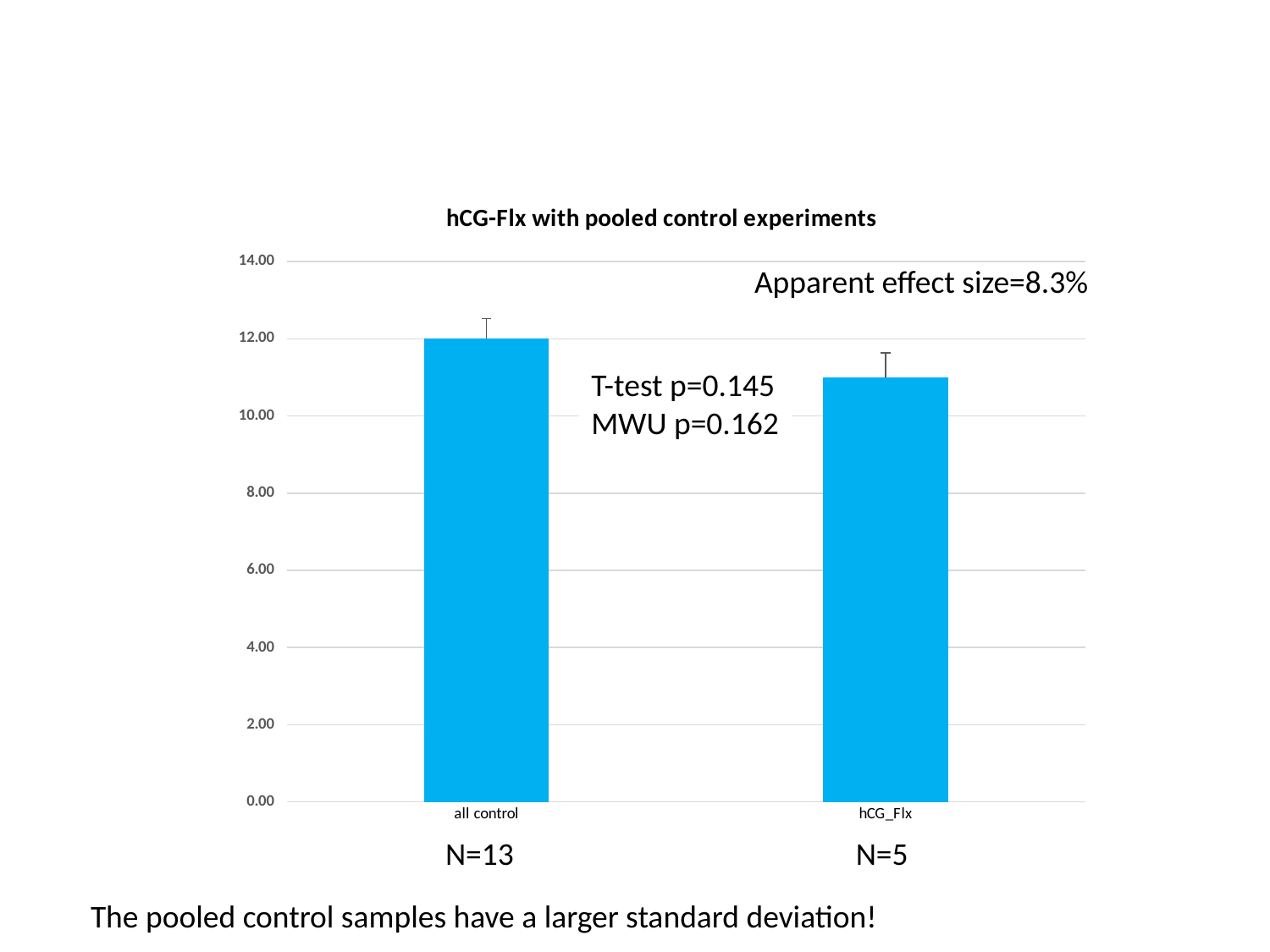
Is the value for hCG_Flx greater or less than 10.00? greater Is the value for all control greater or less than 10.00? greater What is the value of the bar for all control? 12.00 How many bars (categories) are plotted in the chart? 2 What sample size (N) is shown under the all control bar? N=13 What kind of chart is shown on the slide? bar chart What is the title of the chart? hCG-Flx with pooled control experiments Which category has the lowest bar? hCG_Flx Which category has the highest bar? all control Which bar is taller, all control or hCG_Flx? all control Do the bar values rise or fall from all control to hCG_Flx? fall Is the value for hCG_Flx greater or less than 12.00? less